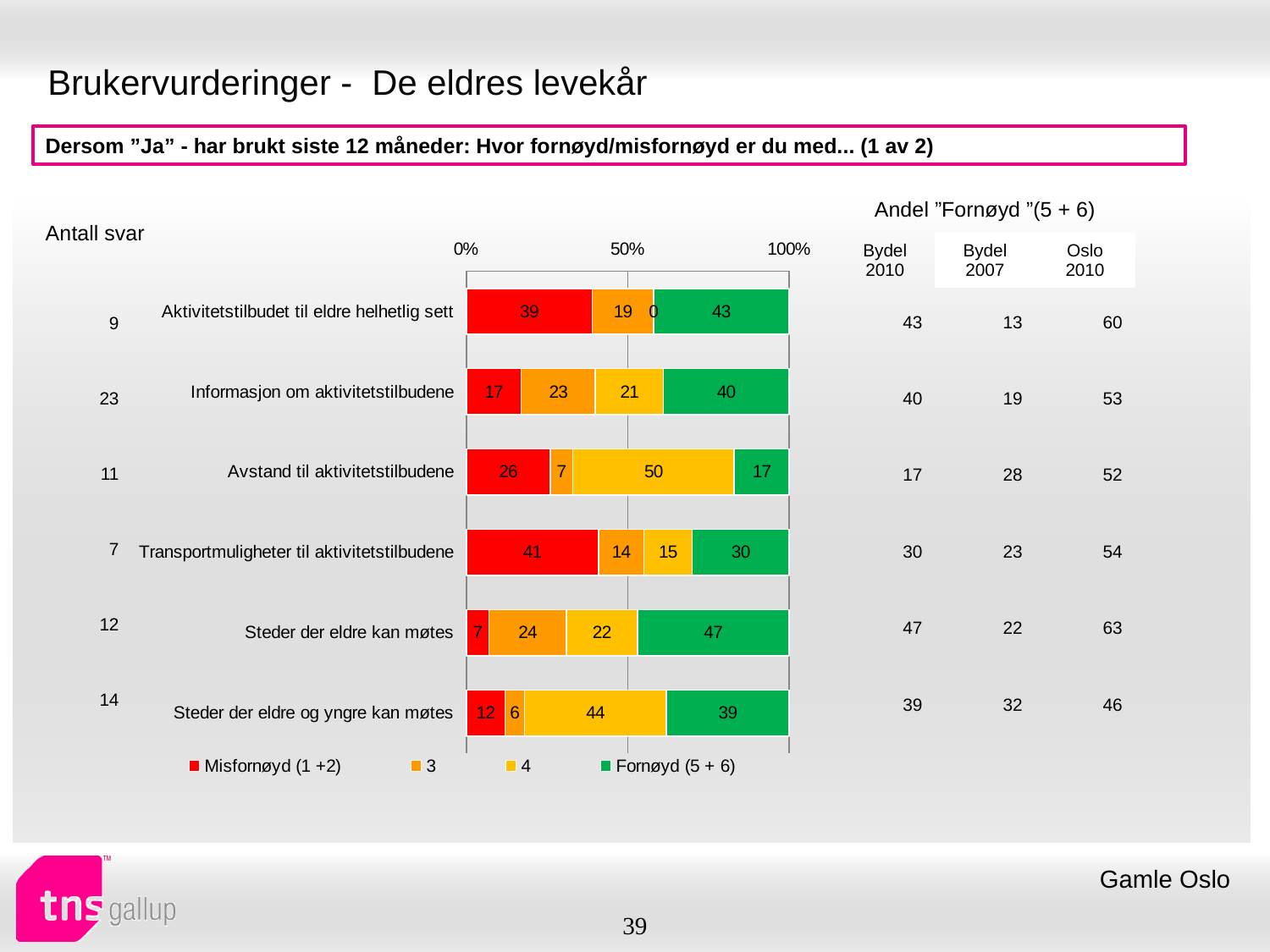
What is the value of the Misfornøyd (1 +2) series for "Transportmuligheter til aktivitetstilbudene"? 41 What is the value of the Fornøyd (5 + 6) series for "Informasjon om aktivitetstilbudene"? 40 What is the difference between the Fornøyd (5 + 6) values for "Steder der eldre kan møtes" and "Steder der eldre og yngre kan møtes"? 8 How many categories are shown in the chart? 6 What is the total of the stacked bar for "Avstand til aktivitetstilbudene"? 100 How many series does the legend list? 4 What is the value of the "4" series for "Avstand til aktivitetstilbudene"? 50 Which category has the lowest value for the Misfornøyd (1 +2) series? Steder der eldre kan møtes Which category has the lowest value for the Fornøyd (5 + 6) series? Avstand til aktivitetstilbudene Which is larger: the Misfornøyd (1 +2) value for "Aktivitetstilbudet til eldre helhetlig sett" or for "Avstand til aktivitetstilbudene"? Aktivitetstilbudet til eldre helhetlig sett Which category has the highest value for the Fornøyd (5 + 6) series? Steder der eldre kan møtes What kind of chart is shown on the slide? Stacked bar chart